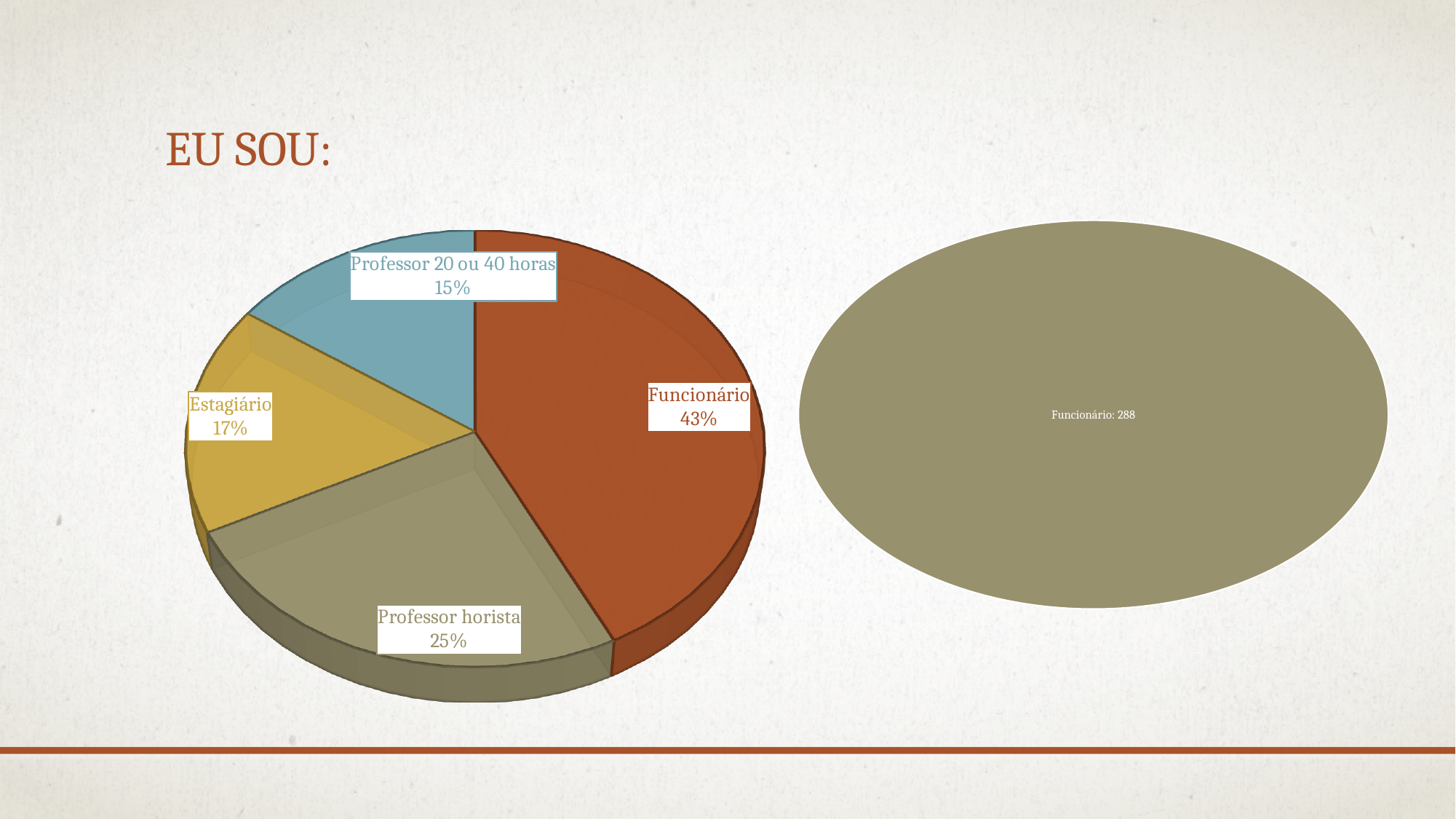
On the left pie chart, what is the share for Estagiário? 17% On the left pie chart, which category has the largest slice? Funcionário On the left pie chart, what is the difference in percentage points between Funcionário and Professor horista? 18 On the left pie chart, which category has the smallest slice? Professor 20 ou 40 horas On the left pie chart, what is the share for Professor horista? 25% On the left pie chart, what is the share for Professor 20 ou 40 horas? 15% On the left pie chart, what is the share for Funcionário? 43% What kind of chart is shown on the left of the slide? Pie chart How many slices does the left pie chart have? 4 On the left pie chart, what colour is the Funcionário slice? Red-brown On the left pie chart, which is larger: Estagiário or Professor horista? Professor horista What value is printed on the chart on the right of the slide for Funcionário? 288